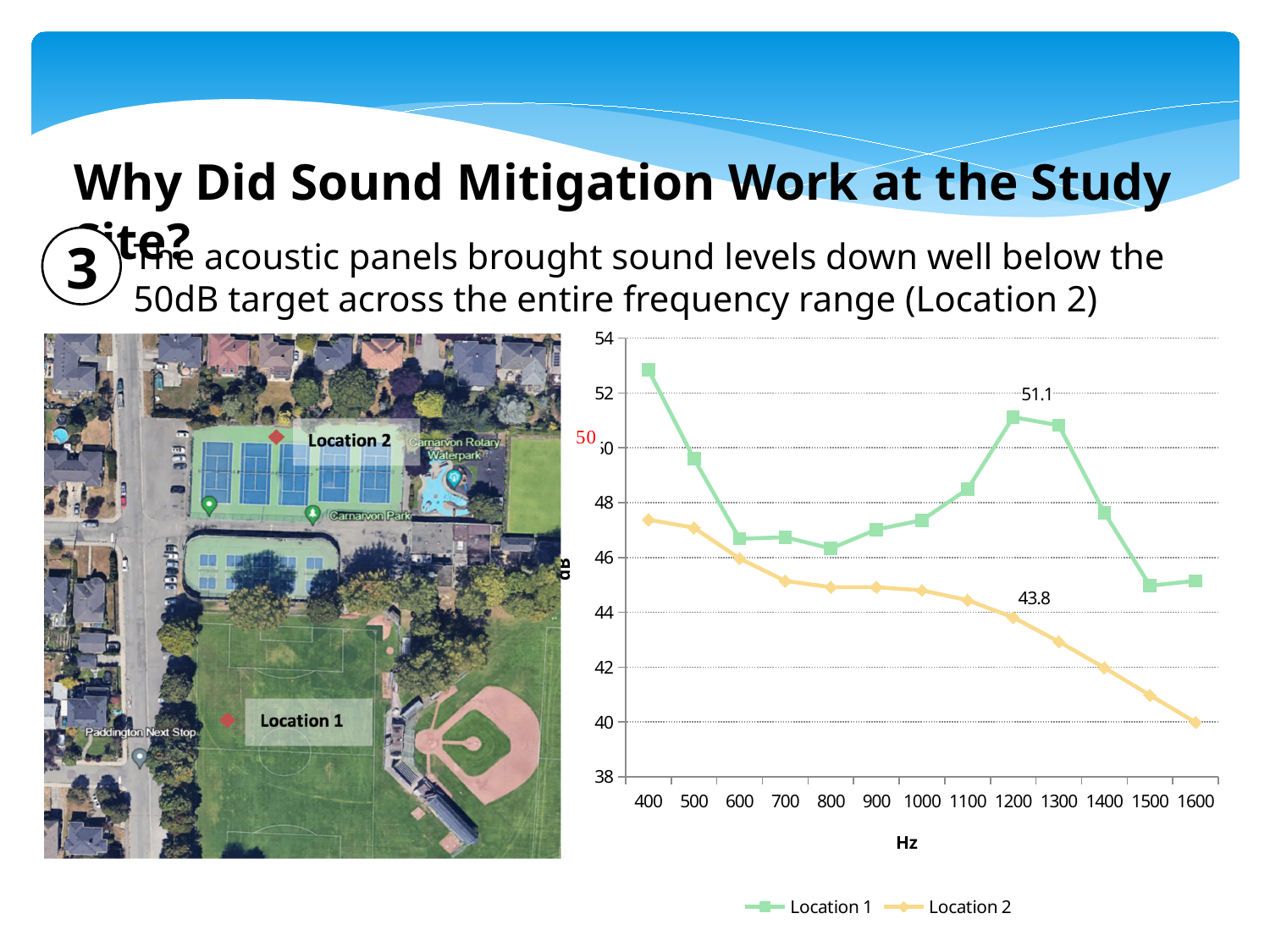
What is the difference between the Location 1 and Location 2 values at 1200 Hz? 7.3 At 1200 Hz, which series has the larger value, Location 1 or Location 2? Location 1 Is the value for Location 2 at 1600 Hz greater or less than 42? less Is the value for Location 1 at 400 Hz greater or less than 52? greater How many frequency points are plotted along the x axis of the chart? 13 How many series does the chart's legend list? 2 Does the Location 2 series rise or fall as frequency increases along the x axis? fall What is the labelled value for Location 1 at 1200 Hz? 51.1 What kind of chart is shown on the slide? line chart What is the label on the x axis of the chart? Hz At which frequency does Location 2 reach its lowest value? 1600 Hz What is the labelled value for Location 2 at 1200 Hz? 43.8